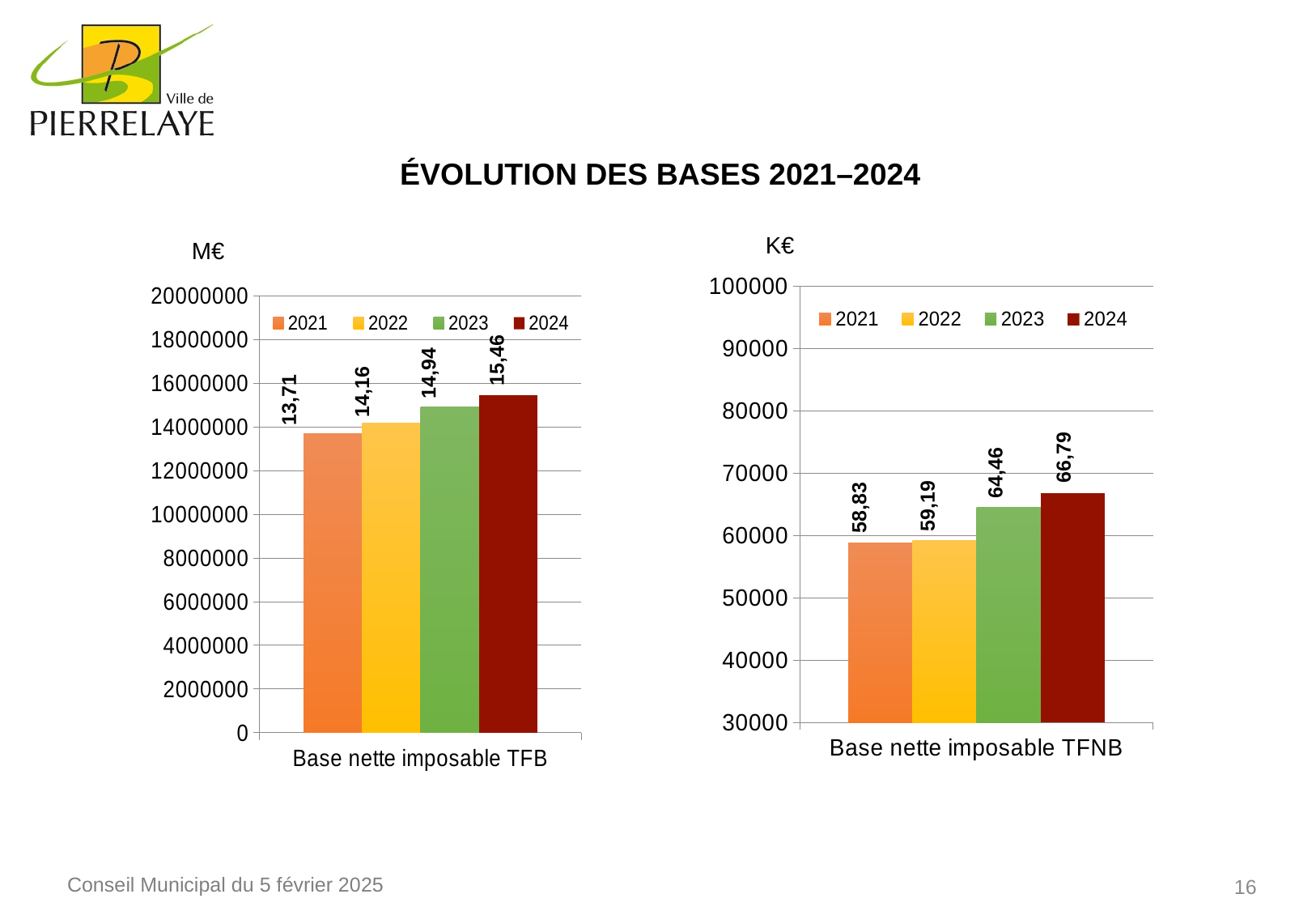
What kind of chart is the 'Base nette imposable TFNB' chart? bar chart In the 'Base nette imposable TFB' chart, what is the difference between the 2024 and 2021 data labels? 1,75 In the 'Base nette imposable TFNB' chart, which is larger, the value for 2022 or the value for 2023? 2023 In the 'Base nette imposable TFNB' chart, what is the difference between the 2024 and 2021 data labels? 7,96 In the 'Base nette imposable TFNB' chart, is the bar for 2024 greater or less than 60000? greater How many series does the legend of the 'Base nette imposable TFB' chart list? 4 In the 'Base nette imposable TFB' chart, is the bar for 2021 greater or less than 14000000? less In the 'Base nette imposable TFNB' chart, what is the data label for 2023? 64,46 In the 'Base nette imposable TFB' chart, which year has the highest value? 2024 In the 'Base nette imposable TFNB' chart, which year has the lowest value? 2021 In the 'Base nette imposable TFB' chart, do the values rise or fall from 2021 to 2024? rise In the 'Base nette imposable TFB' chart, what is the data label for 2021? 13,71